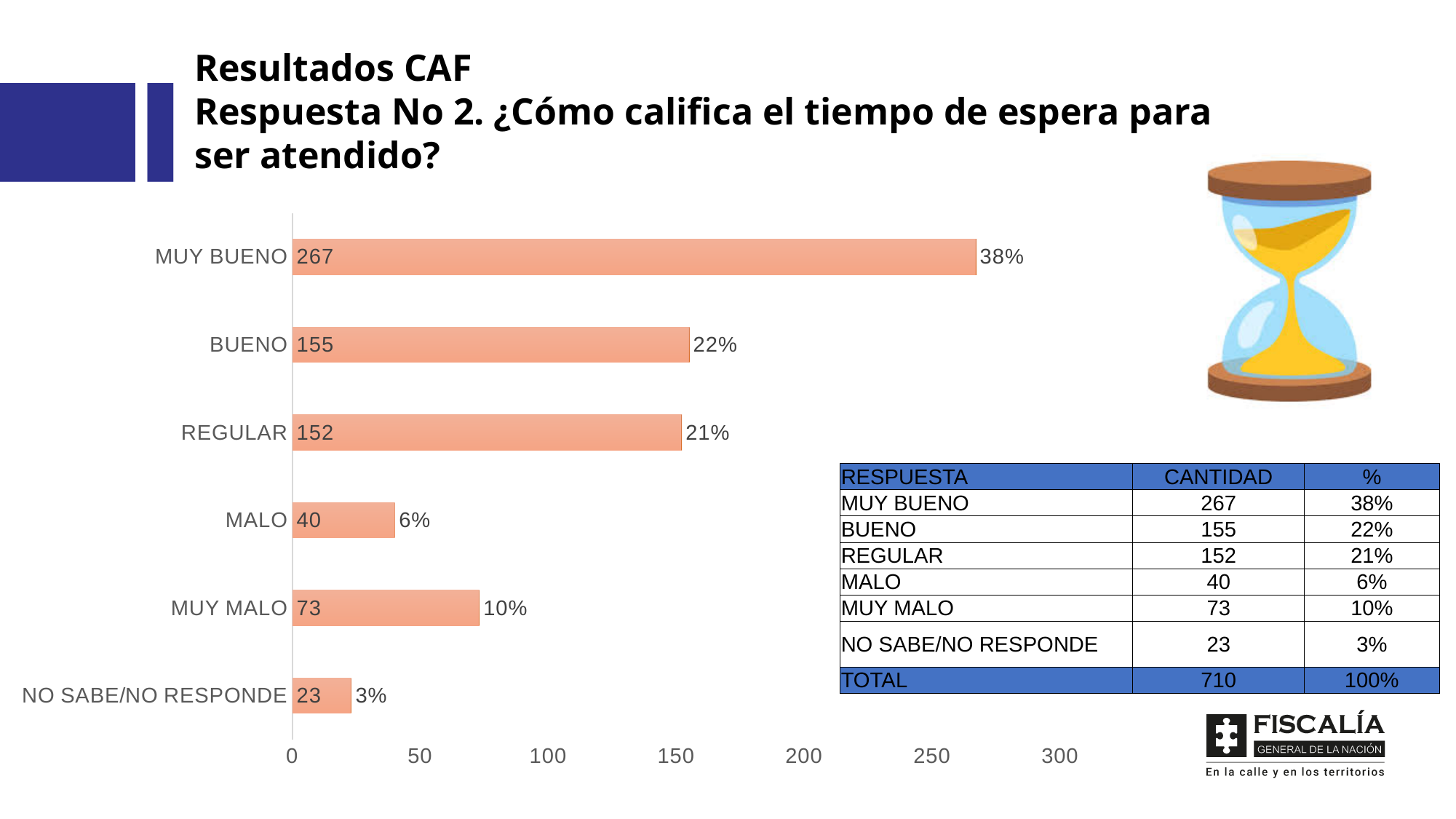
What kind of chart is shown on the slide? bar chart What is the difference between the values for MUY BUENO and BUENO? 112 What is the value for NO SABE/NO RESPONDE? 23 Which category has the highest value? MUY BUENO What is the value for MUY BUENO? 267 How many categories are shown in the chart? 6 Which category has the lowest value? NO SABE/NO RESPONDE What percentage is shown for BUENO? 22% Is the value for REGULAR greater or less than 100? greater What is the total of all the category values shown in the chart? 710 Which is larger, the value for MALO or the value for MUY MALO? MUY MALO What is the difference between the values for MUY MALO and MALO? 33